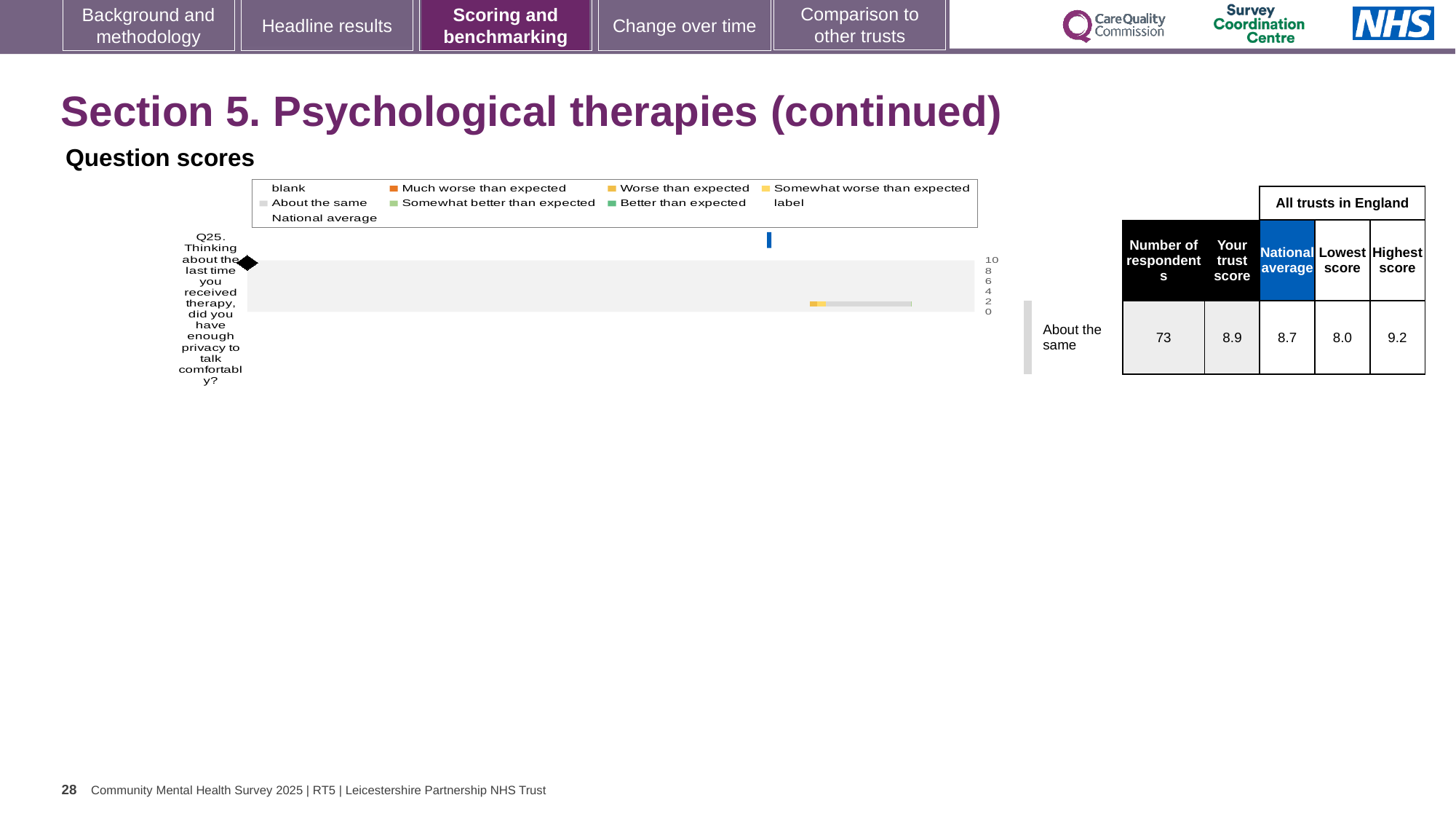
For Q25, what is the difference between the trust's score and the national average? 0.2 For Q25, which is larger: the trust's score or the national average? the trust's score How many survey questions are plotted in the Question scores chart? 1 Which benchmark category is Q25 placed in on the slide? About the same What is the lowest score among all trusts in England for Q25? 8.0 How many respondents answered Q25? 73 For Q25, what is the difference between the highest and lowest scores among all trusts in England? 1.2 What is the trust's score for Q25 (privacy to talk comfortably during therapy)? 8.9 What is the highest score among all trusts in England for Q25? 9.2 What is the national average score for Q25? 8.7 In the Question scores chart legend, what does the blue marker represent? National average What kind of chart is shown under 'Question scores'? bar chart